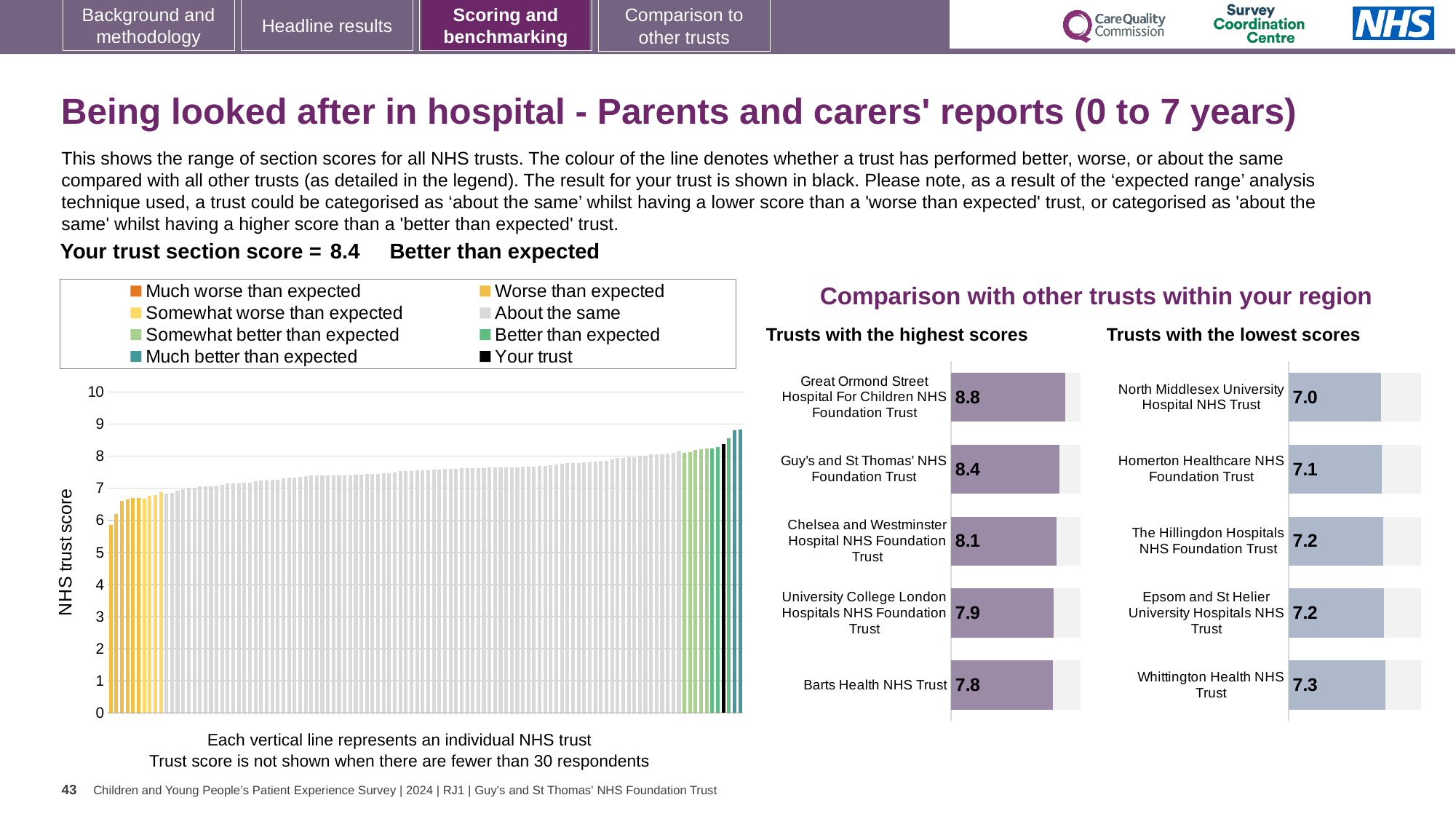
In the 'Trusts with the lowest scores' chart, what is the score for Homerton Healthcare NHS Foundation Trust? 7.1 How many trusts are shown in the 'Trusts with the highest scores' chart? 5 In the 'Trusts with the lowest scores' chart, what is the difference between the scores of Whittington Health NHS Trust and North Middlesex University Hospital NHS Trust? 0.3 In the large chart on the left, is the highest trust score greater or less than 8? greater In the large chart on the left, do the NHS trust scores rise or fall from left to right? Rise In the 'Trusts with the highest scores' chart, which has the higher score: Chelsea and Westminster Hospital NHS Foundation Trust or University College London Hospitals NHS Foundation Trust? Chelsea and Westminster Hospital NHS Foundation Trust In the 'Trusts with the lowest scores' chart, which trust has the lowest score? North Middlesex University Hospital NHS Trust In the 'Trusts with the highest scores' chart, what is the difference between the scores of Great Ormond Street Hospital For Children NHS Foundation Trust and Barts Health NHS Trust? 1.0 What kind of chart is the large chart on the left showing NHS trust scores? Bar chart In the 'Trusts with the highest scores' chart, which trust has the highest score? Great Ormond Street Hospital For Children NHS Foundation Trust In the 'Trusts with the highest scores' chart, what is the score for Great Ormond Street Hospital For Children NHS Foundation Trust? 8.8 How many entries does the legend of the large chart on the left list? 8